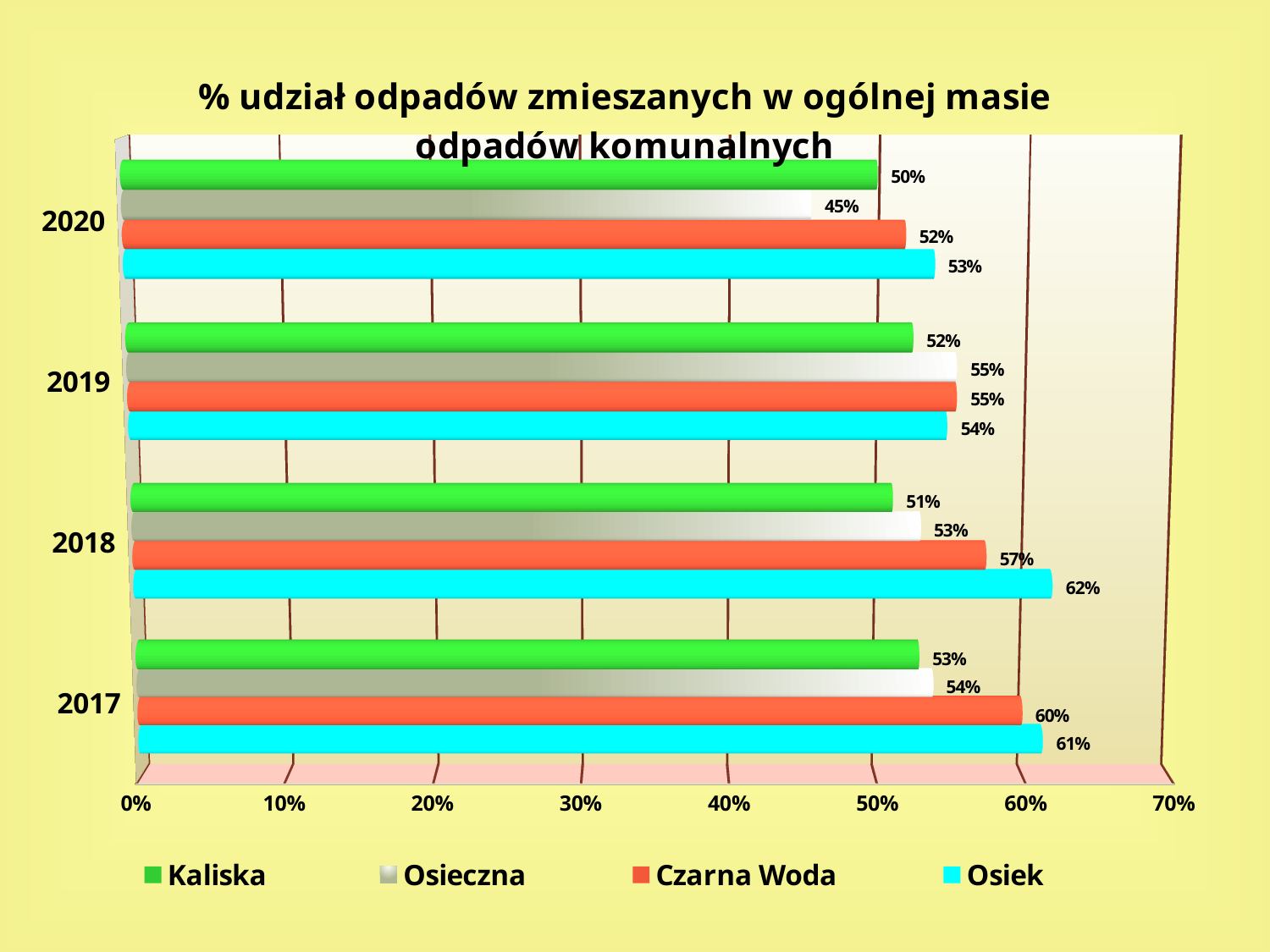
What kind of chart is shown on the slide? Bar chart Which series has the lowest value in 2020? Osieczna Which series has the highest value in 2018? Osiek Which is larger in 2017: the value for Czarna Woda or the value for Kaliska? Czarna Woda What is the value for Czarna Woda in 2017? 60% How many years are shown on the chart? 4 What is the value for Kaliska in 2019? 52% What is the value for Osiek in 2018? 62% What is the difference between the Osiek and Kaliska values in 2018? 11% What is the value for Osieczna in 2020? 45% How many series does the legend list? 4 Which colour represents Osiek in the chart? Cyan